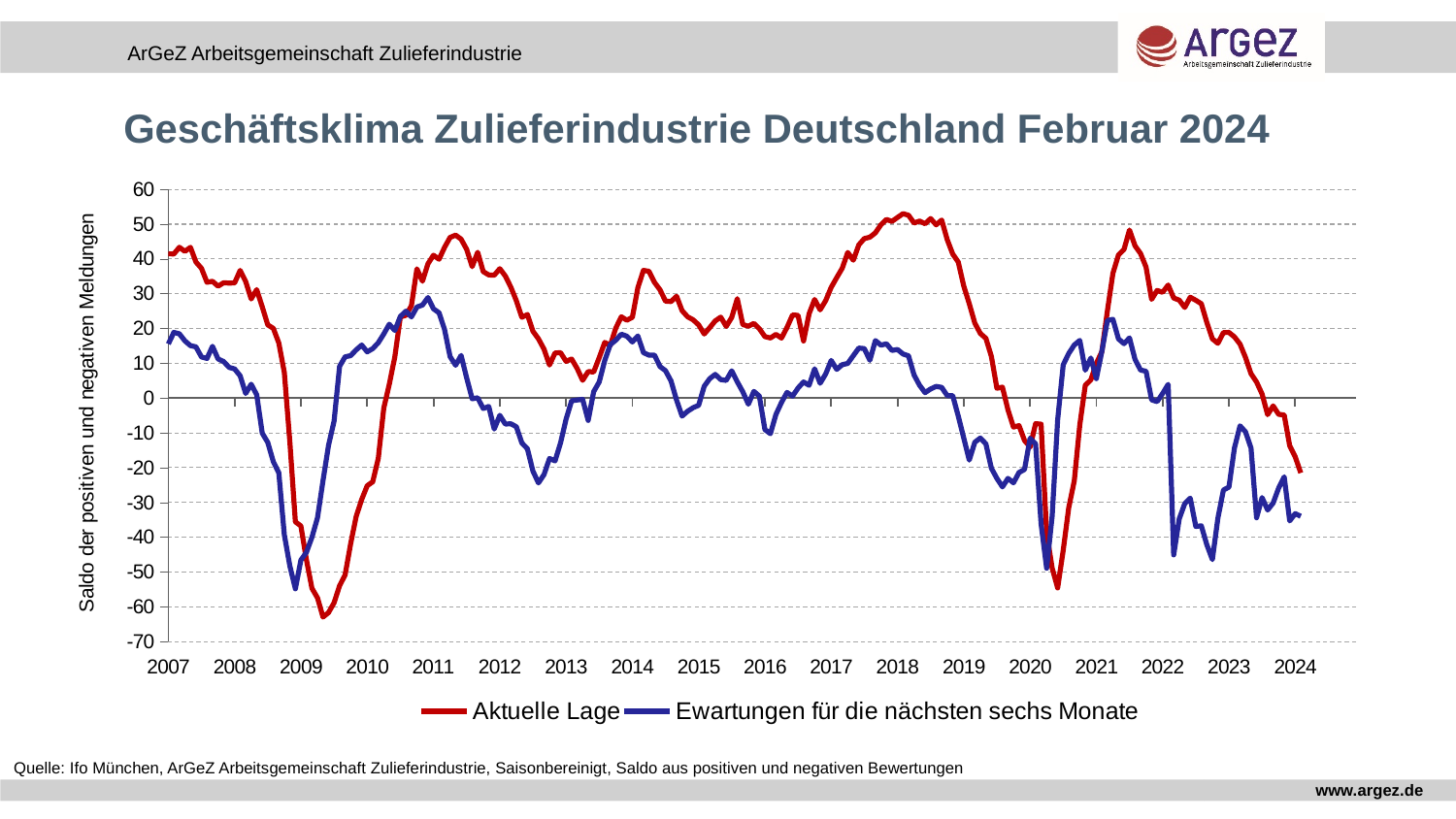
Which series is drawn in red? Aktuelle Lage Does Aktuelle Lage rise or fall from its low in 2009 to 2011? rise Is the value of Aktuelle Lage at the end of the series in 2024 greater or less than 0? less Is the lowest value of Aktuelle Lage around 2009 greater or less than -50? less Around 2018, which series has the higher value, Aktuelle Lage or Ewartungen für die nächsten sechs Monate? Aktuelle Lage What is the title of the chart? Geschäftsklima Zulieferindustrie Deutschland Februar 2024 Does Aktuelle Lage rise or fall from its peak in 2021 to the end of the series in 2024? fall What kind of chart is shown on the slide? line chart Is the value of Ewartungen für die nächsten sechs Monate at the end of the series in 2024 greater or less than -20? less How many series does the legend list? 2